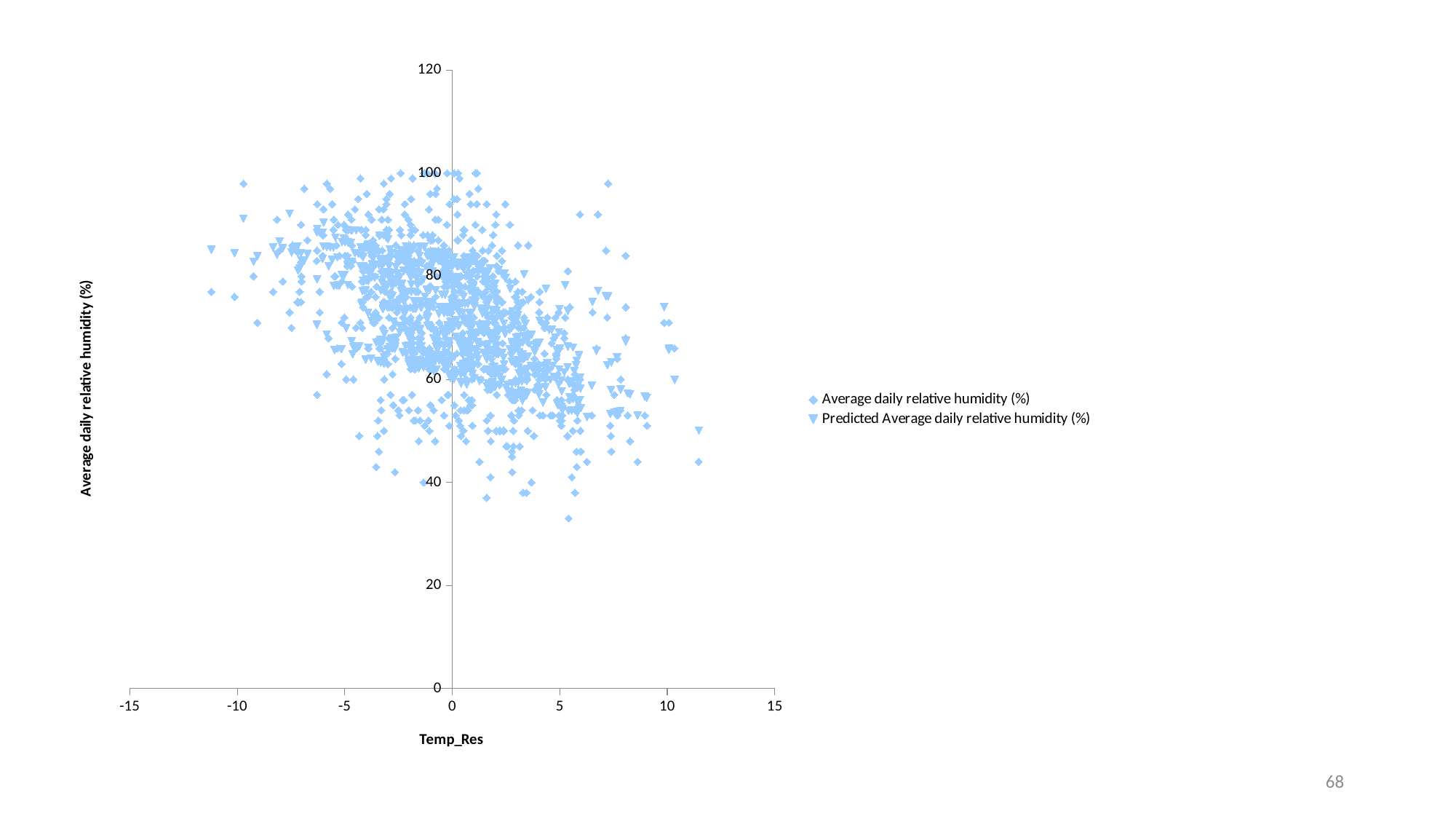
Are the lowest plotted points greater or less than 20 on the y axis? greater What is the minimum value shown on the x axis? -15 What kind of chart is shown on the slide? scatter chart Do the plotted humidity values generally rise or fall as Temp_Res increases along the x axis? fall What is the maximum value shown on the y axis? 120 How many series does the legend list? 2 What is the title of the y axis? Average daily relative humidity (%)